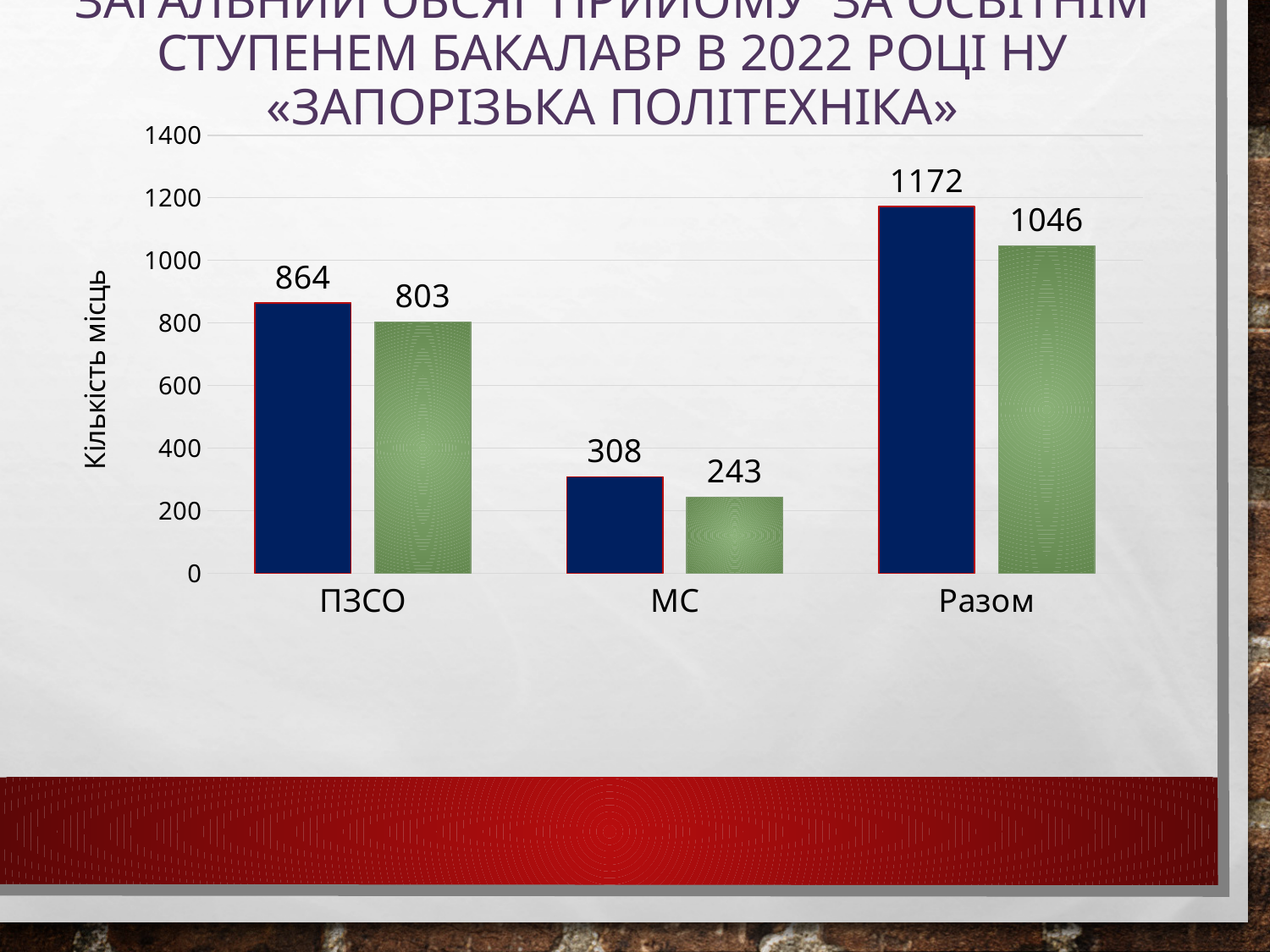
Which is larger for ПЗСО: the dark blue bar or the green bar? the dark blue bar What is the value of the dark blue bar for МС? 308 What is the value of the dark blue bar for Разом? 1172 Which category has the lowest dark blue bar? МС What is the value of the green bar for Разом? 1046 What kind of chart is shown on the slide? bar chart What is the value of the green bar for МС? 243 How many categories are shown on the x axis? 3 What is the difference between the dark blue and green bars for Разом? 126 What is the value of the green bar for ПЗСО? 803 What is the value of the dark blue bar for ПЗСО? 864 Which category has the highest green bar? Разом